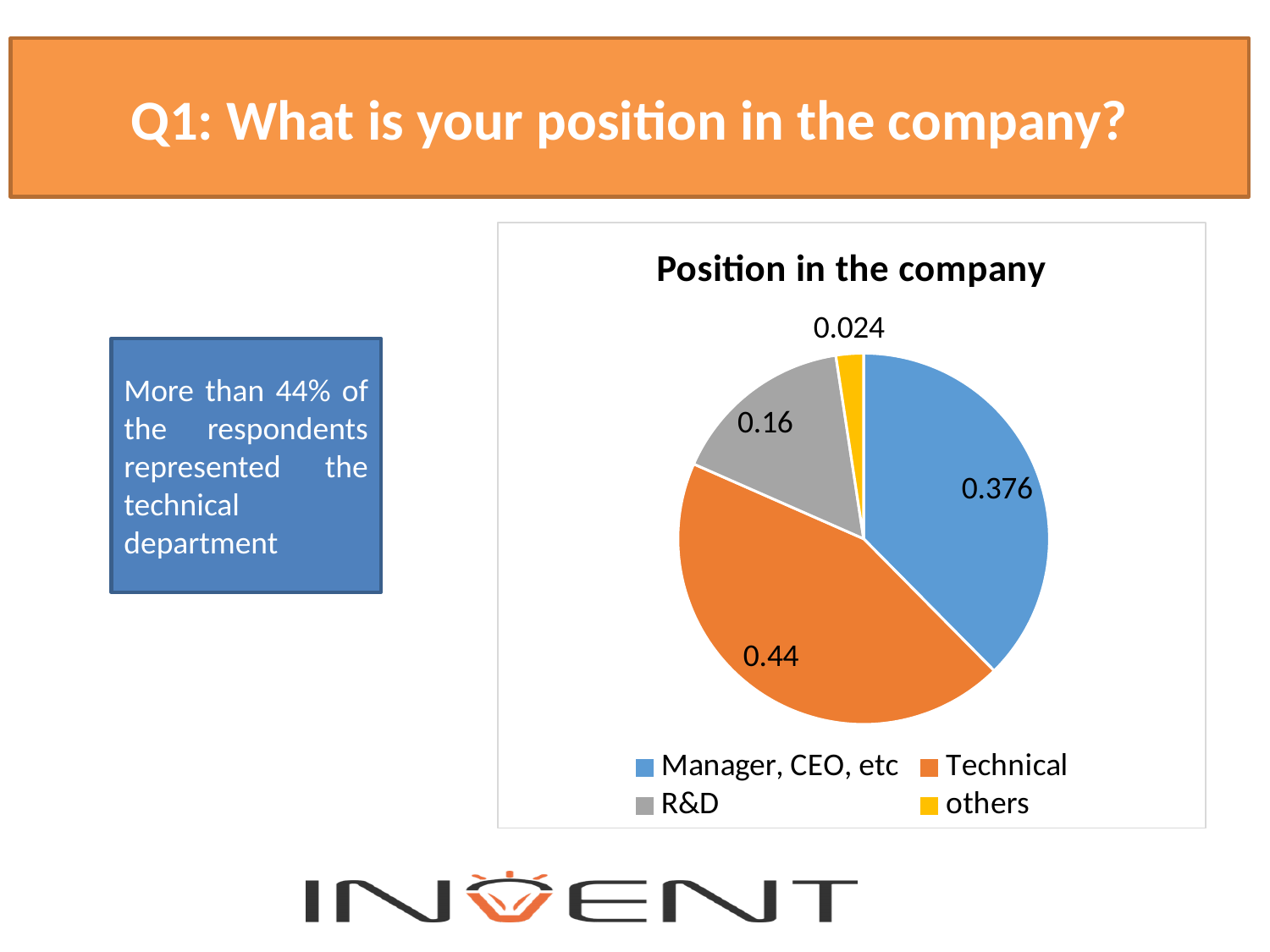
What is the value for Technical? 0.44 Which category has the smallest slice? others Which category has the largest slice? Technical What is the value for others? 0.024 How many categories does the legend list? 4 What colour is the slice for R&D? grey What is the value for R&D? 0.16 Which is larger, the value for R&D or the value for others? R&D What is the title of the chart? Position in the company What is the value for Manager, CEO, etc? 0.376 What is the difference between the values for Technical and Manager, CEO, etc? 0.064 What type of chart is shown on the slide? pie chart